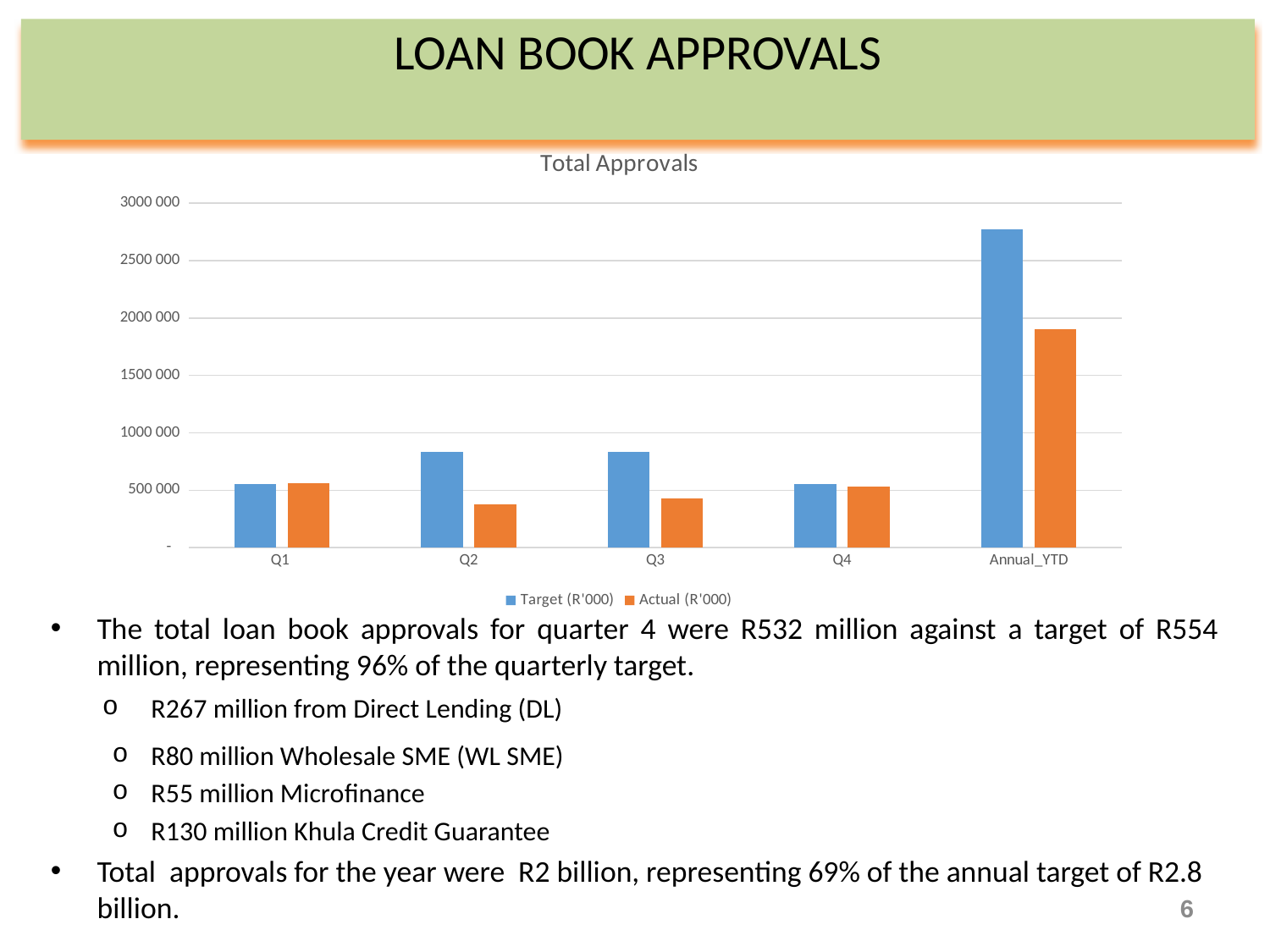
How many series does the legend list? 2 How many categories are shown on the x axis? 5 For Q3, which is larger, the Target (R'000) or the Actual (R'000) value? Target (R'000) Which colour represents the Actual (R'000) series? orange What is the title of the chart? Total Approvals Is the Target (R'000) value for Annual_YTD greater or less than 2500 000? greater Is the Target (R'000) value for Q2 greater or less than 500 000? greater Which category has the highest Actual (R'000) value? Annual_YTD What kind of chart is shown on the slide? bar chart Is the Actual (R'000) value for Annual_YTD greater or less than 2000 000? less Which category has the highest Target (R'000) value? Annual_YTD